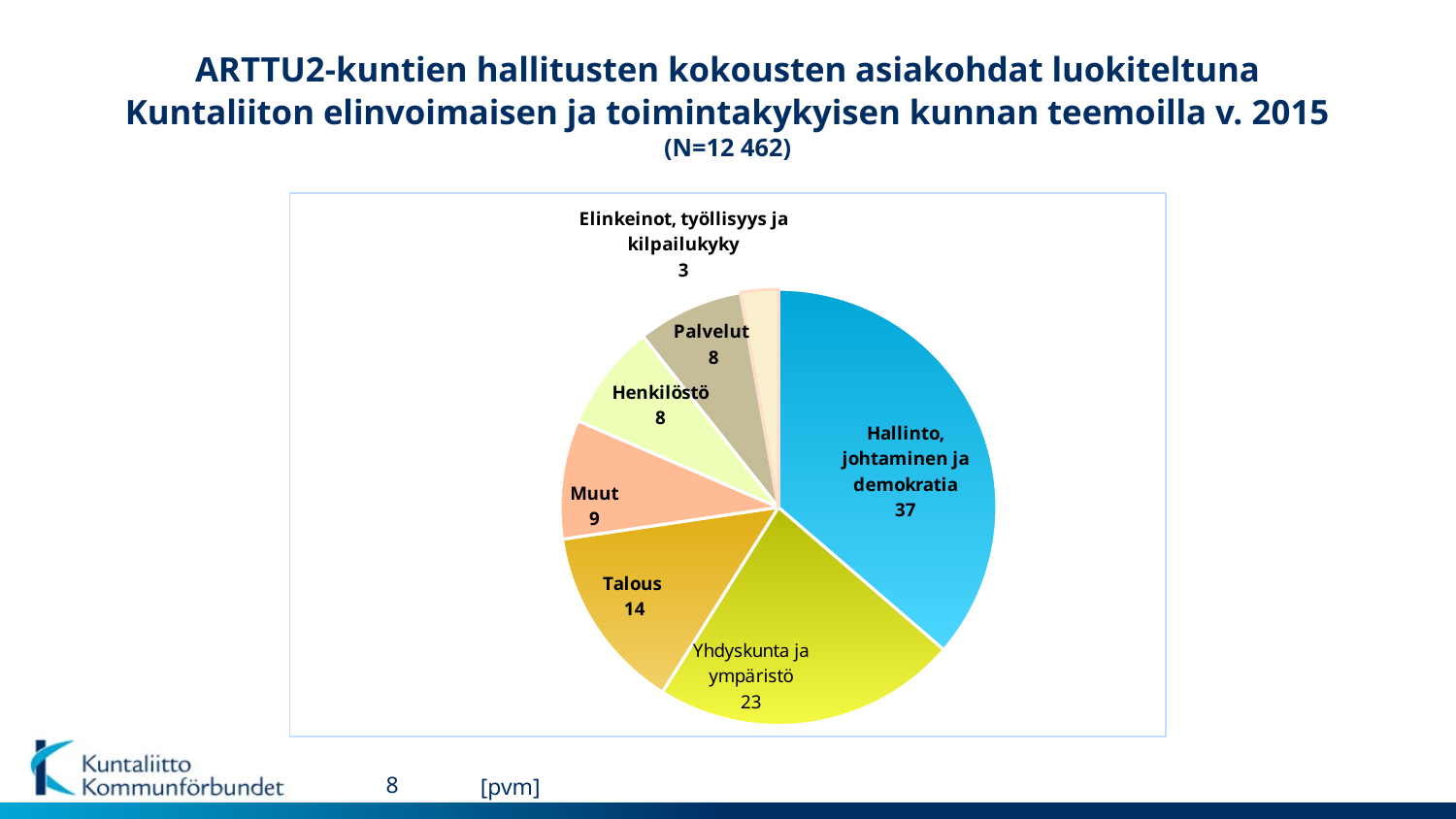
Which category has the smallest slice of the pie? Elinkeinot, työllisyys ja kilpailukyky What is the N (sample size) stated under the chart title? N=12 462 What is the value shown for Yhdyskunta ja ympäristö? 23 Which is larger, the value for Talous or the value for Muut? Talous What is the value shown for Hallinto, johtaminen ja demokratia? 37 What is the difference between the values for Talous and Muut? 5 What is the difference between the values for Hallinto, johtaminen ja demokratia and Yhdyskunta ja ympäristö? 14 Which category has the largest slice of the pie? Hallinto, johtaminen ja demokratia What is the value shown for Elinkeinot, työllisyys ja kilpailukyky? 3 What is the value shown for Talous? 14 How many categories (slices) does the pie chart have? 7 What kind of chart is shown on the slide? Pie chart